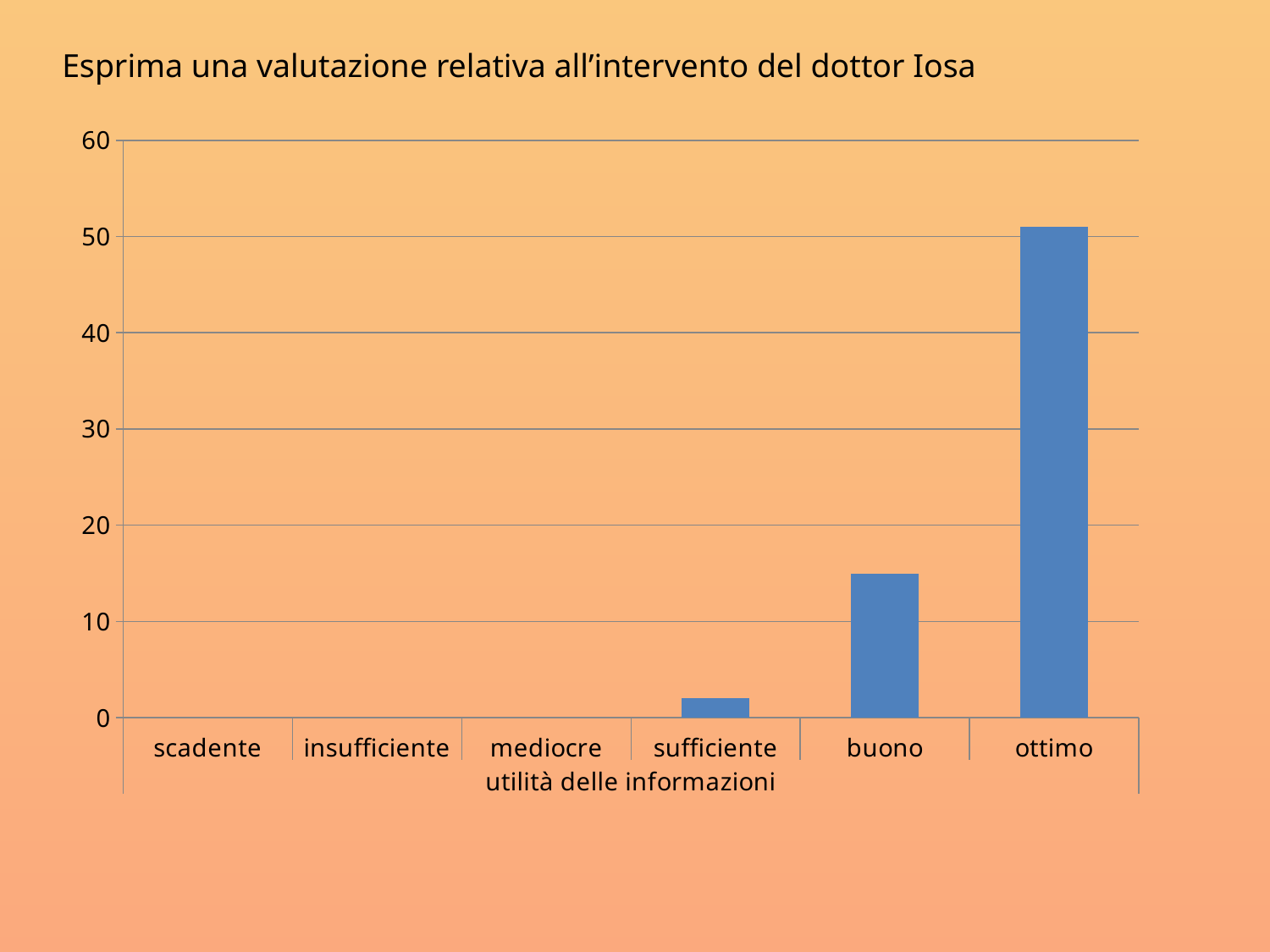
Is the value for sufficiente greater or less than 10? less Is the value for buono greater or less than 20? less Do the values generally rise or fall moving from scadente to ottimo along the x axis? rise Which has a larger value, buono or ottimo? ottimo Is the value for buono greater or less than 10? greater How many categories are shown on the x axis of the chart? 6 What is the title of the slide above the chart? Esprima una valutazione relativa all'intervento del dottor Iosa What is the label shown on the x axis of the chart? utilità delle informazioni What kind of chart is shown on the slide? bar chart Which has a larger value, sufficiente or buono? buono Which category has the highest value in the chart? ottimo